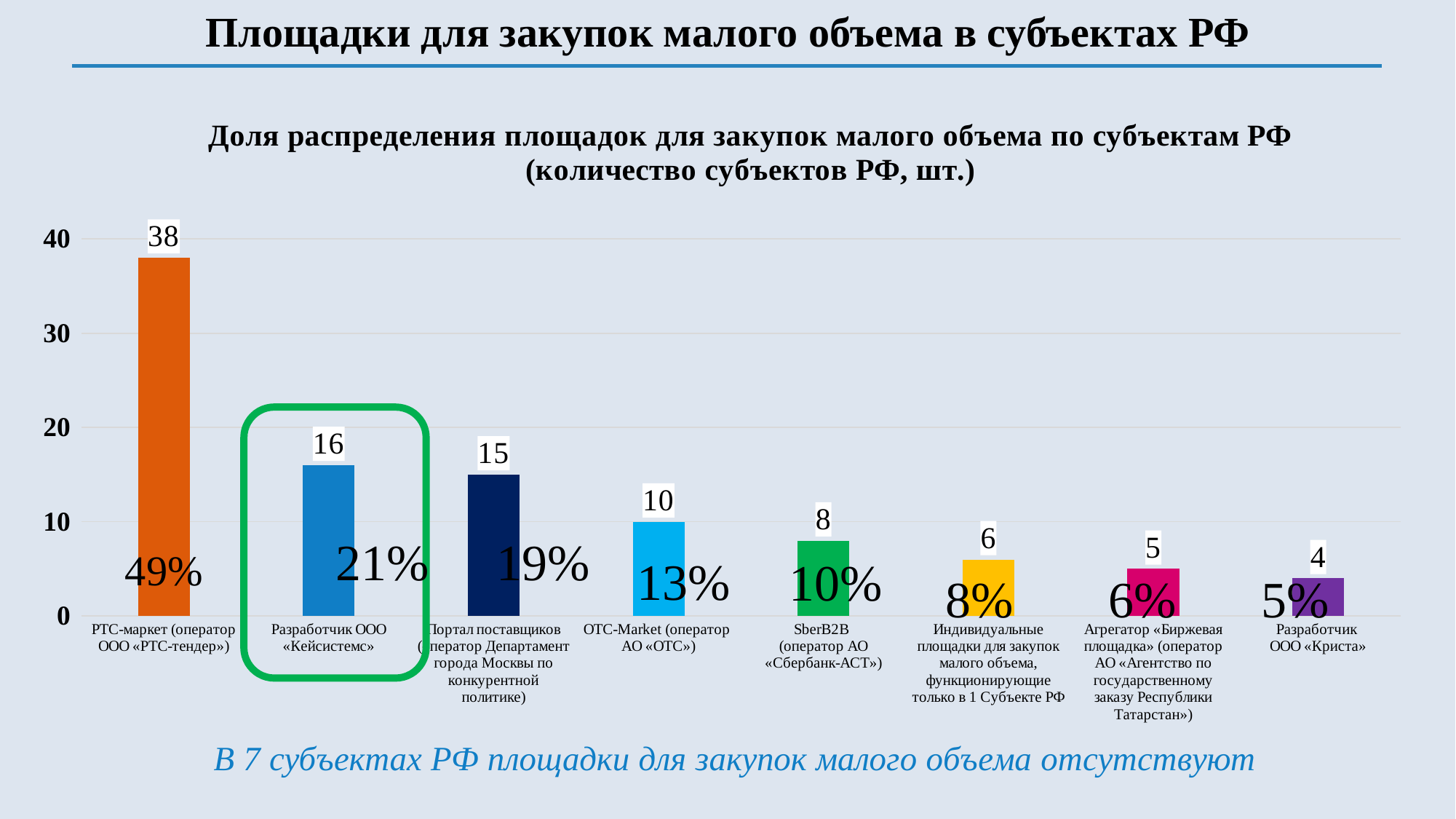
Do the values rise or fall from left to right along the x axis? fall Which category has the lowest value? Разработчик ООО «Криста» What percentage share is printed on the bar for Портал поставщиков (оператор Департамент города Москвы по конкурентной политике)? 19% Which is larger, the value for OTC-Market (оператор АО «ОТС») or the value for SberB2B (оператор АО «Сбербанк-АСТ»)? OTC-Market (оператор АО «ОТС») What kind of chart is shown on the slide? bar chart What is the value for Разработчик ООО «Криста»? 4 What is the value for РТС-маркет (оператор ООО «РТС-тендер»)? 38 What is the value for Разработчик ООО «Кейсистемс»? 16 What is the difference between the values for РТС-маркет (оператор ООО «РТС-тендер») and Разработчик ООО «Кейсистемс»? 22 What is the value for SberB2B (оператор АО «Сбербанк-АСТ»)? 8 Which category has the highest value? РТС-маркет (оператор ООО «РТС-тендер») How many categories are shown in the chart? 8